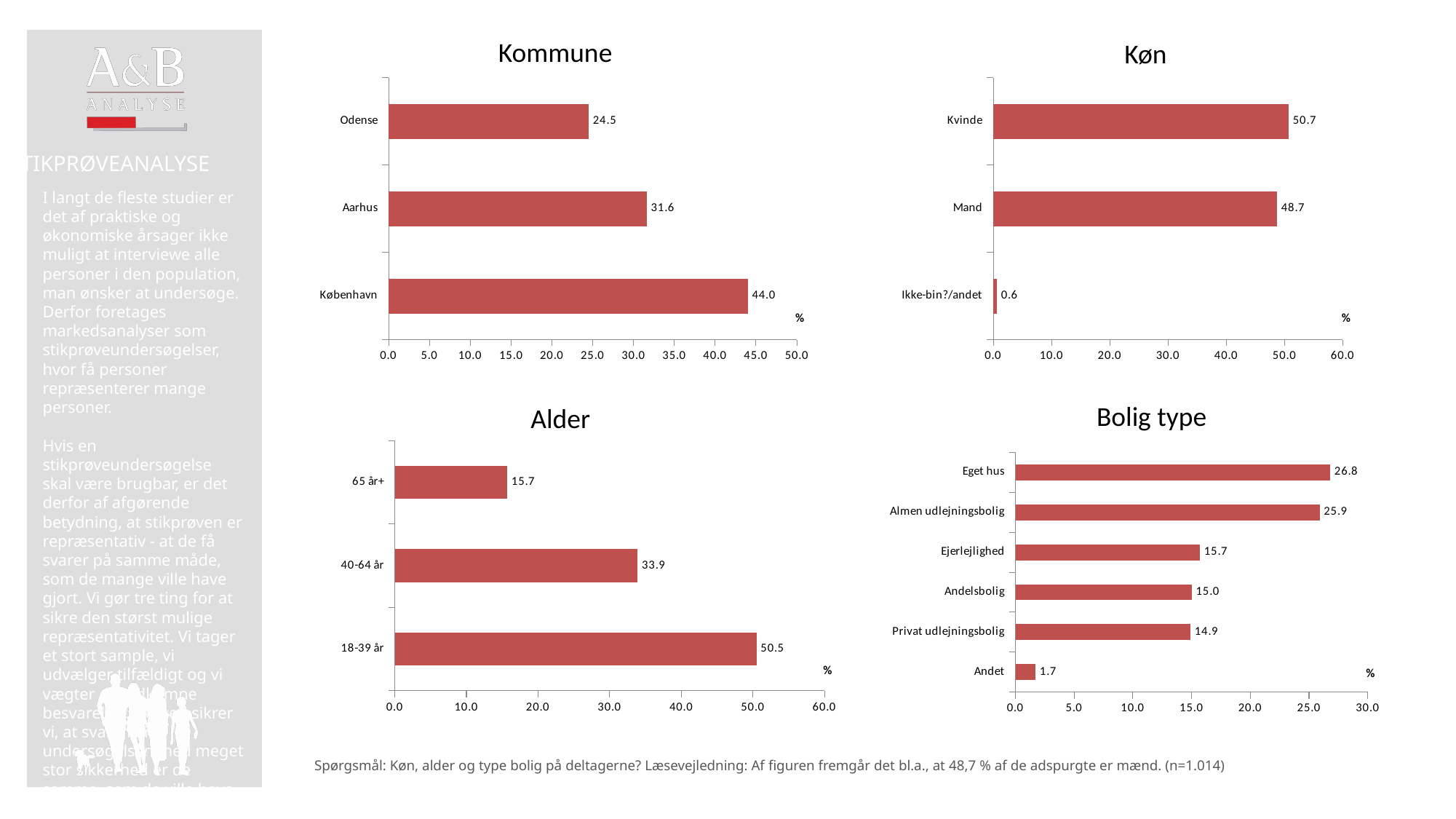
In the 'Køn' chart, which category has the lowest value? Ikke-bin?/andet In the 'Køn' chart, which is larger, Kvinde or Mand? Kvinde In the 'Alder' chart, how many categories are shown? 3 In the 'Kommune' chart, what is the difference between København and Odense? 19.5 In the 'Køn' chart, what is the value for Mand? 48.7 In the 'Alder' chart, what is the value for 18-39 år? 50.5 In the 'Bolig type' chart, what is the value for Ejerlejlighed? 15.7 In the 'Bolig type' chart, how many categories are shown? 6 In the 'Alder' chart, what is the difference between 40-64 år and 65 år+? 18.2 In the 'Kommune' chart, which category has the highest value? København What kind of chart is the 'Bolig type' chart? Bar chart In the 'Kommune' chart, what is the value for Aarhus? 31.6